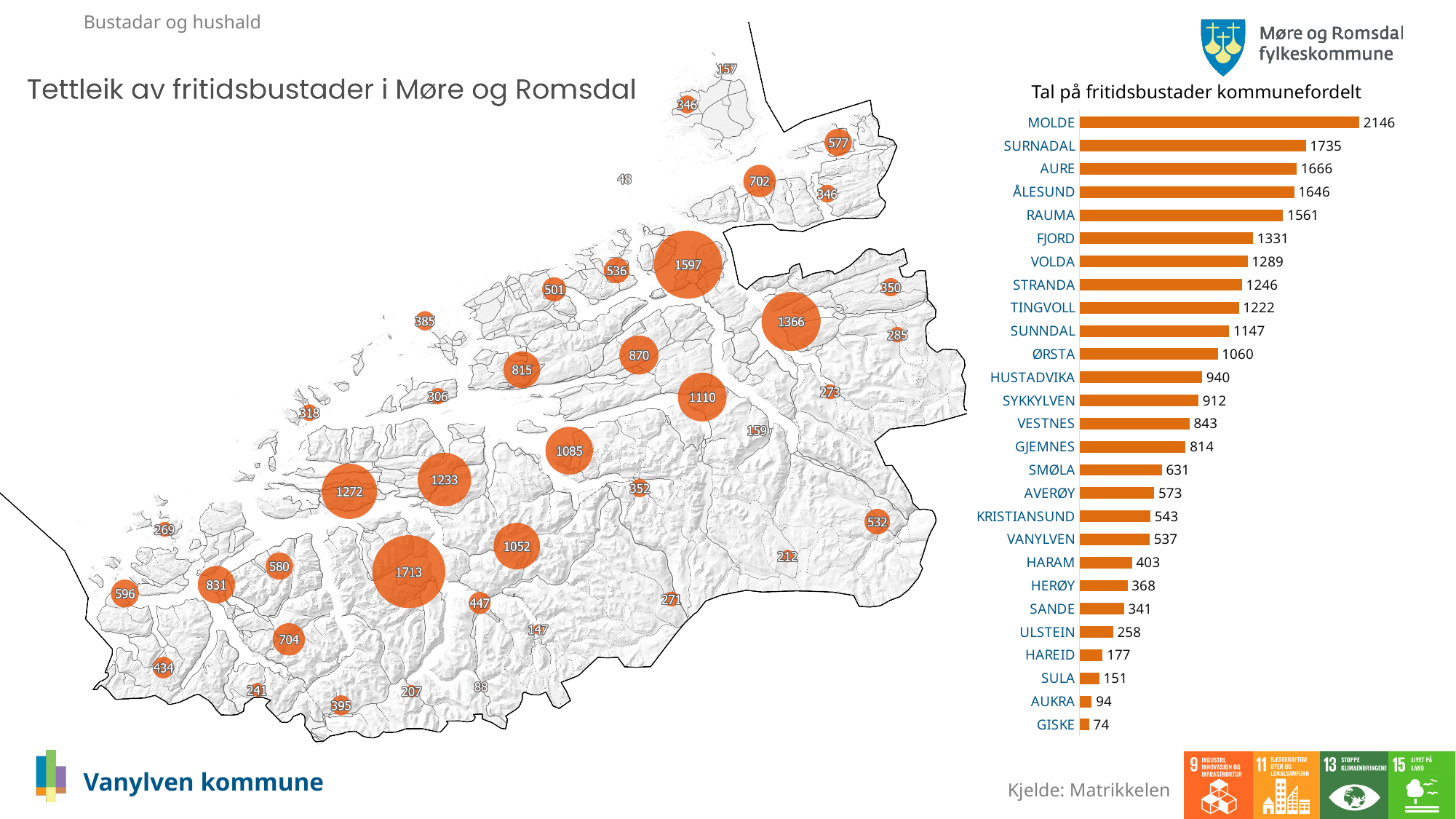
In the bar chart 'Tal på fritidsbustader kommunefordelt', which is larger, the value for VOLDA or the value for STRANDA? VOLDA In the bar chart 'Tal på fritidsbustader kommunefordelt', what is the value for HUSTADVIKA? 940 In the bar chart 'Tal på fritidsbustader kommunefordelt', what is the difference between the values for AURE and ÅLESUND? 20 What kind of chart is 'Tal på fritidsbustader kommunefordelt'? Bar chart In the bar chart 'Tal på fritidsbustader kommunefordelt', what is the value for MOLDE? 2146 In the bar chart 'Tal på fritidsbustader kommunefordelt', which is larger, the value for HERØY or the value for SANDE? HERØY In the bar chart 'Tal på fritidsbustader kommunefordelt', which municipality has the lowest value? GISKE In the bar chart 'Tal på fritidsbustader kommunefordelt', which municipality has the highest value? MOLDE In the bar chart 'Tal på fritidsbustader kommunefordelt', what is the difference between the values for MOLDE and SURNADAL? 411 In the bar chart 'Tal på fritidsbustader kommunefordelt', what is the value for VANYLVEN? 537 How many municipalities are listed in the bar chart 'Tal på fritidsbustader kommunefordelt'? 27 What is the title of the chart on the right side of the slide? Tal på fritidsbustader kommunefordelt